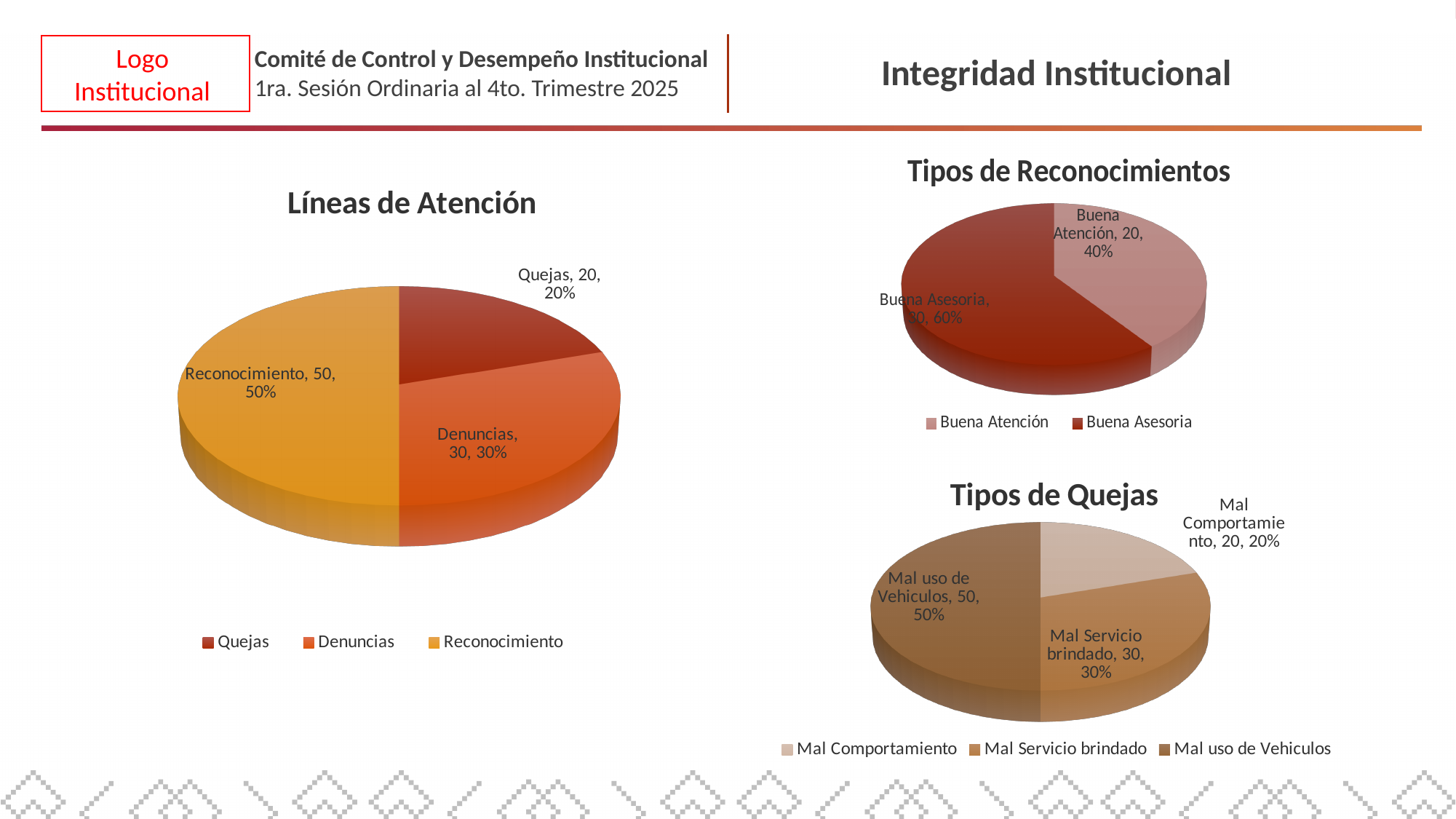
What type of chart is 'Tipos de Reconocimientos'? Pie chart In the 'Líneas de Atención' chart, what value is shown for Denuncias? 30 In the 'Tipos de Quejas' chart, which category has the largest slice? Mal uso de Vehiculos In the 'Tipos de Reconocimientos' chart, what value is shown for Buena Asesoria? 30 How many categories does the 'Líneas de Atención' chart show? 3 In the 'Líneas de Atención' chart, which category has the largest slice? Reconocimiento In the 'Tipos de Quejas' chart, what value is shown for Mal Servicio brindado? 30 In the 'Líneas de Atención' chart, what share of the pie does Reconocimiento represent? 50% In the 'Líneas de Atención' chart, what is the difference between the values for Reconocimiento and Quejas? 30 In the 'Líneas de Atención' chart, which category has the smallest slice? Quejas In the 'Tipos de Reconocimientos' chart, what share of the pie does Buena Atención represent? 40% How many entries does the legend of the 'Tipos de Quejas' chart list? 3